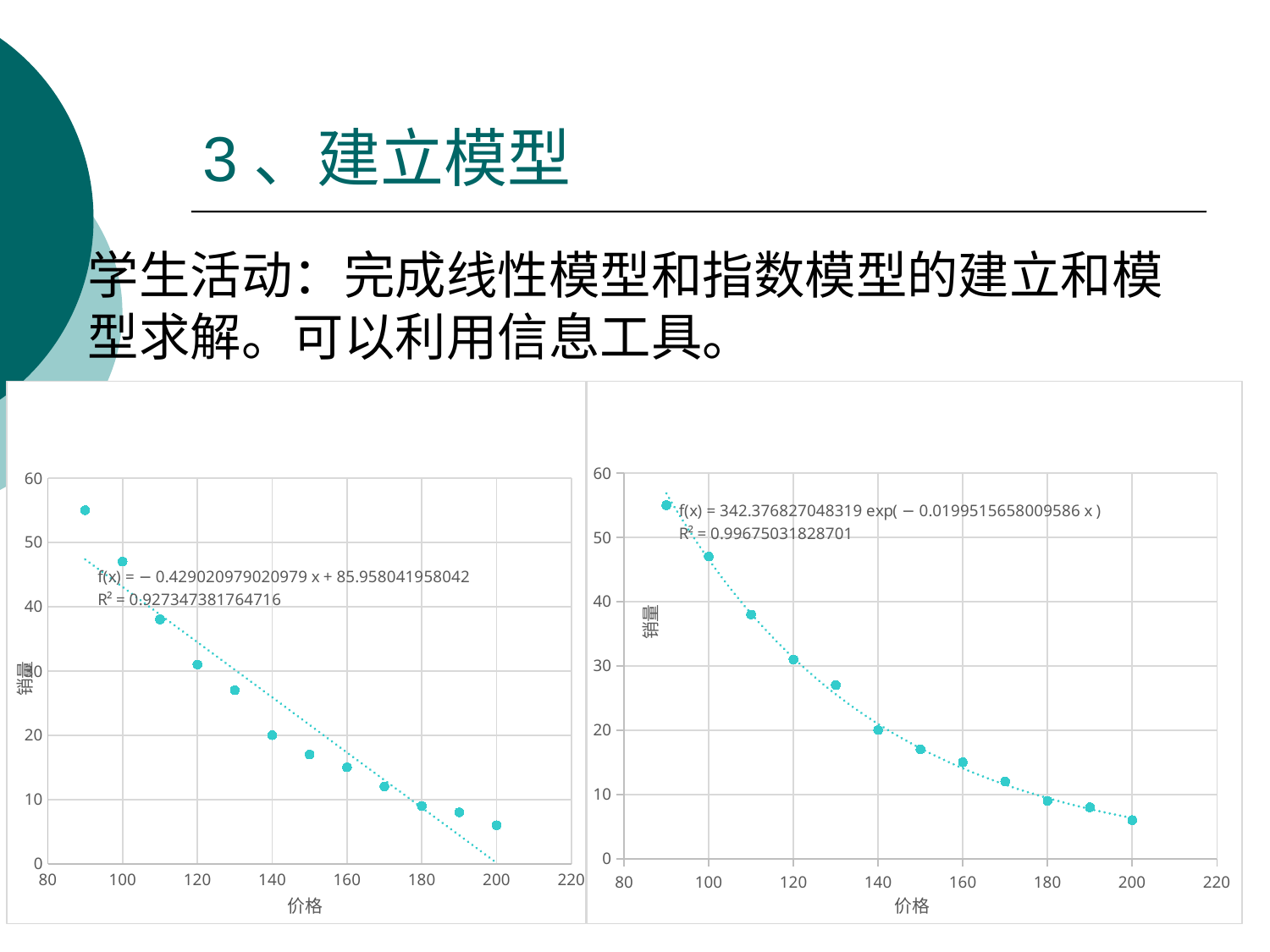
What R² value is shown on the right chart? 0.99675031828701 In the right chart, is the 销量 value at 价格 200 greater or less than 10? less In the left chart, how many data points are plotted? 12 What kind of chart is the left chart? scatter chart In the right chart, at which 价格 is 销量 lowest? 200 In the right chart, do the 销量 values rise or fall as 价格 increases? fall In the right chart, how many data points are plotted? 12 In the left chart, is the 销量 value at 价格 90 greater or less than 50? greater In the left chart, which is larger: the 销量 value at 价格 100 or at 价格 150? 价格 100 In the left chart, is the 销量 value at 价格 110 greater or less than 40? less In the left chart, at which 价格 is 销量 highest? 90 In the left chart, do the 销量 values rise or fall as 价格 increases? fall